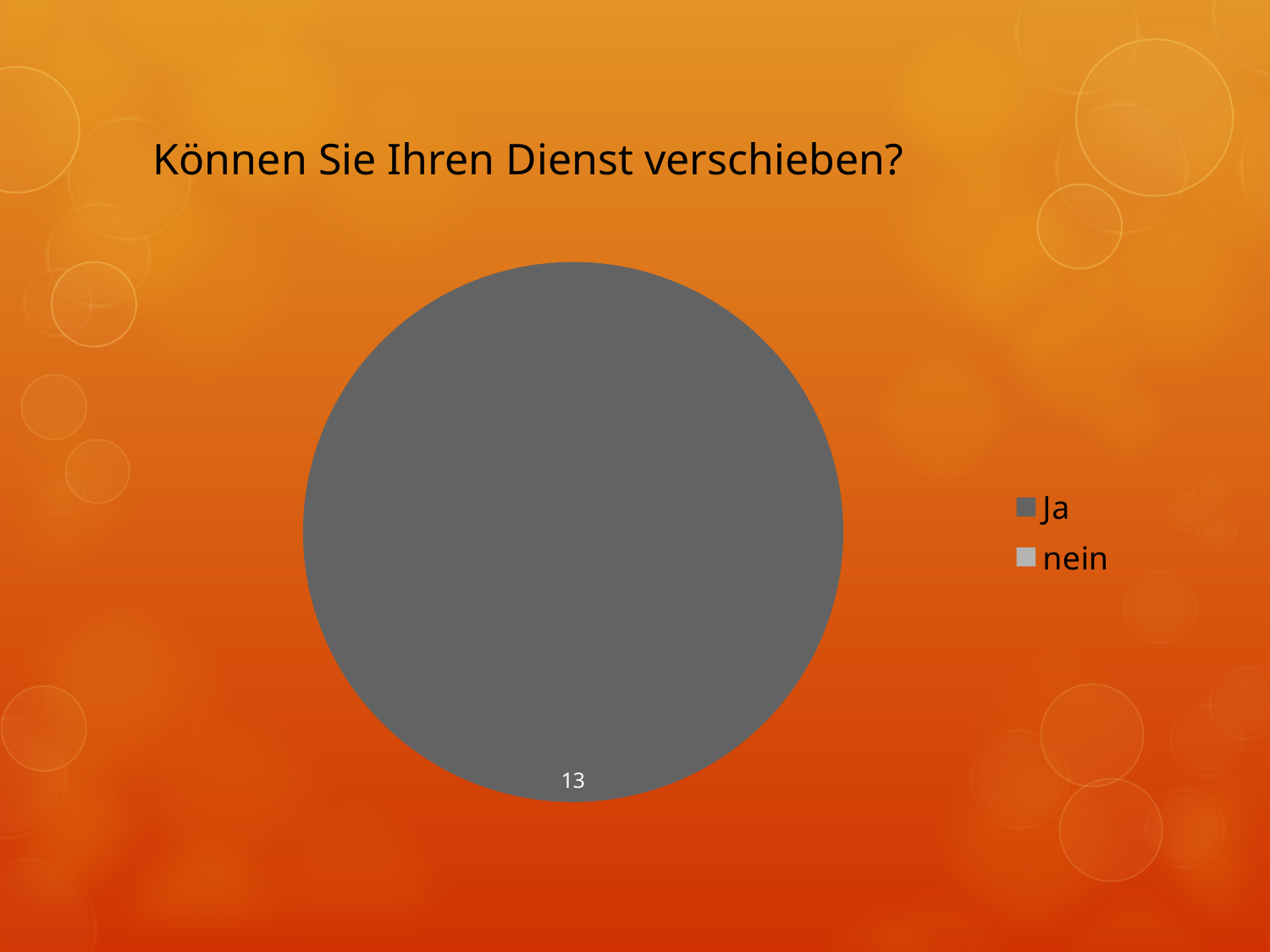
Which is larger, the slice for "Ja" or the slice for "nein"? Ja What is the title of the chart? Können Sie Ihren Dienst verschieben? How many entries does the legend list? 2 Which category has the largest slice of the pie? Ja Is the value for "Ja" greater or less than 10? greater What are the two categories listed in the legend? Ja, nein Which category has the smallest slice of the pie? nein What kind of chart is shown on the slide? pie chart What value is printed on the pie chart for "Ja"? 13